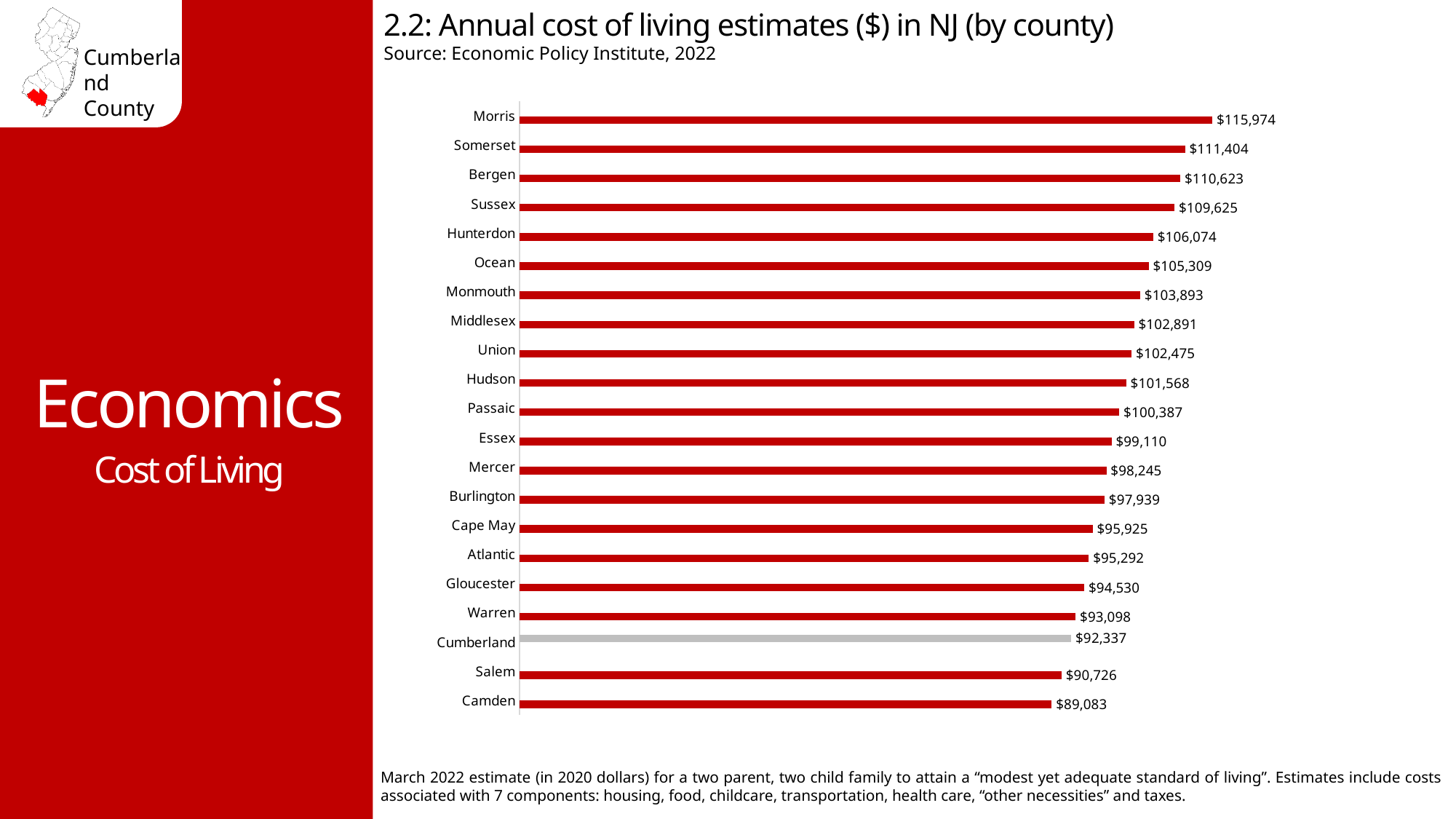
Which county has the lowest annual cost of living estimate? Camden What is the annual cost of living estimate for Hudson County? $101,568 What is the annual cost of living estimate for Cumberland County? $92,337 Which county has a higher cost of living estimate, Ocean or Monmouth? Ocean Which county has the highest annual cost of living estimate? Morris How much higher is Cumberland County's estimate than Salem County's? $1,611 How many counties are shown in the chart? 21 What is the difference between the cost of living estimates for Morris and Camden counties? $26,891 What type of chart is used to show the cost of living estimates? Bar chart Which county has a higher cost of living estimate, Warren or Gloucester? Gloucester What is the annual cost of living estimate for Morris County? $115,974 Which county's bar is shown in grey rather than red? Cumberland